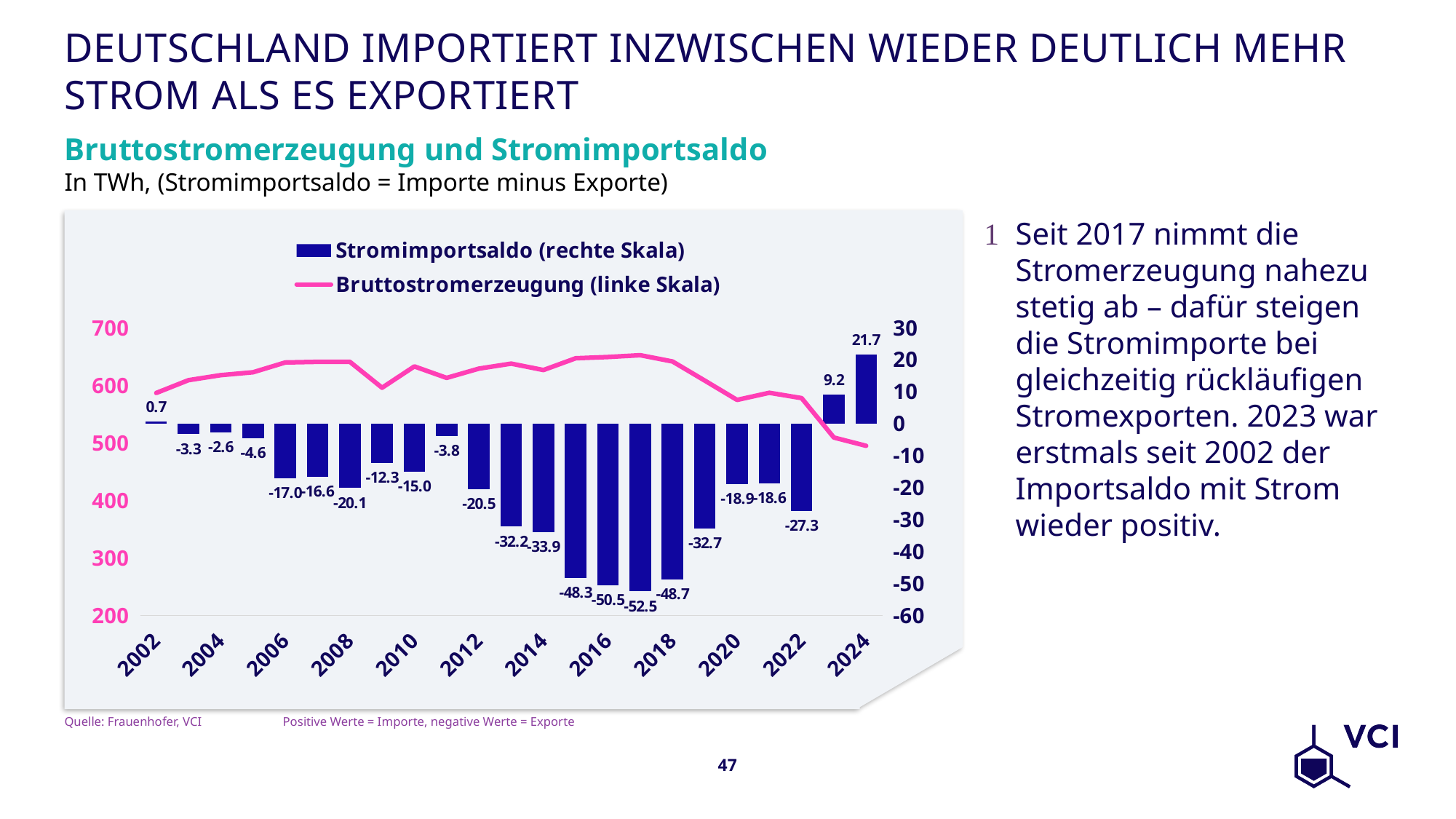
How many series does the chart legend list? 2 What is the Stromimportsaldo value for 2024? 21.7 What kind of chart is shown on the slide? Combined bar and line chart In which year is the Stromimportsaldo highest? 2024 What is the Stromimportsaldo value for 2017? -52.5 What is the difference between the Stromimportsaldo values for 2024 and 2023? 12.5 Which year has the larger Stromimportsaldo value, 2006 or 2012? 2006 What is the Stromimportsaldo value for 2002? 0.7 In which year is the Stromimportsaldo lowest? 2017 Is the Bruttostromerzeugung value for 2016 greater or less than 600? greater Is the Bruttostromerzeugung value for 2002 greater or less than 600? less How many years are plotted on the x axis of the chart? 23